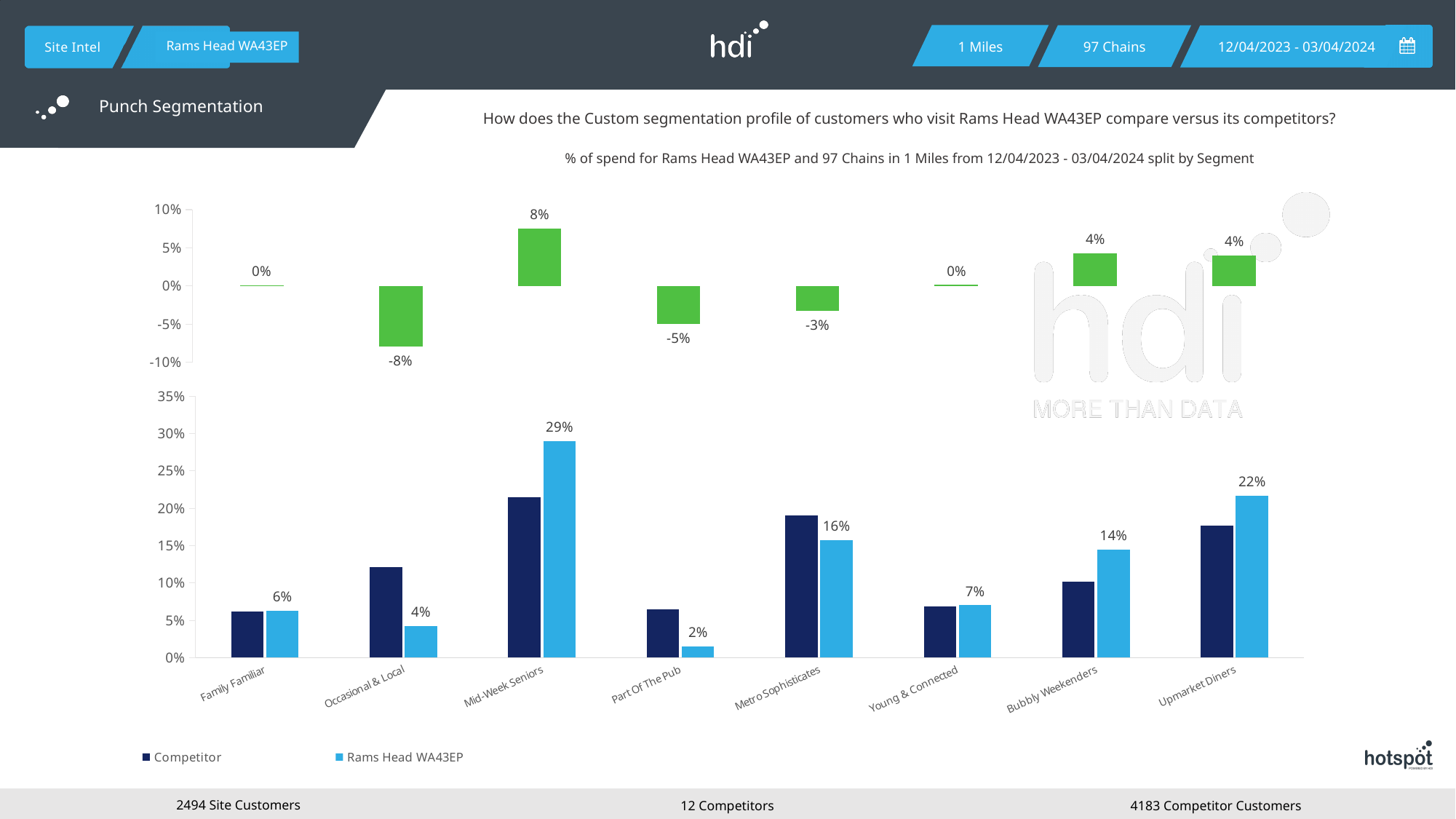
In the bottom chart, what is the value for Rams Head WA43EP in the Mid-Week Seniors segment? 29% In the bottom chart, what colour are the Rams Head WA43EP bars? Light blue In the top chart, what is the value shown for Occasional & Local? -8% In the bottom chart, what is the difference between the Rams Head WA43EP values for Mid-Week Seniors and Upmarket Diners? 7 percentage points What kind of chart is the bottom chart? Bar chart How many series does the legend of the bottom chart list? 2 In the top chart, which segment has the lowest value? Occasional & Local How many segments are shown on the x axis of the bottom chart? 8 In the top chart, which segment has the highest value? Mid-Week Seniors In the bottom chart, which segment has the lowest Rams Head WA43EP value? Part Of The Pub In the bottom chart, for Metro Sophisticates, which series has the larger value: Competitor or Rams Head WA43EP? Competitor In the bottom chart, is the Competitor value for Occasional & Local greater or less than 10%? greater